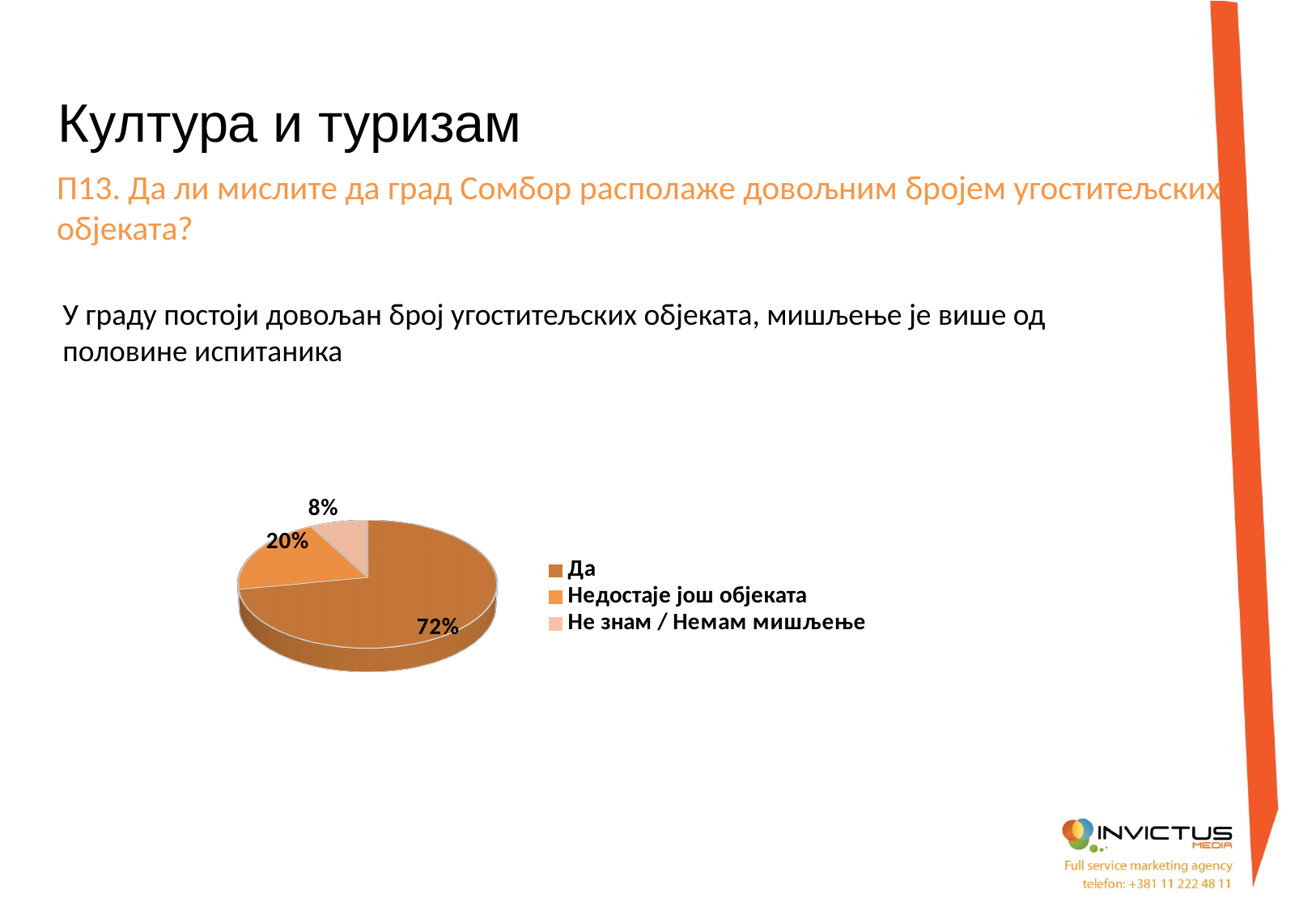
Which response has the largest share of the pie? Да Which response has the smallest share of the pie? Не знам / Немам мишљење Which legend entry is shown in the lightest colour? Не знам / Немам мишљење Which is larger: the share for "Недостаје још објеката" or for "Не знам / Немам мишљење"? Недостаје још објеката How many slices does the pie chart have? 3 What percentage of respondents answered "Недостаје још објеката"? 20% How many entries does the legend list? 3 What percentage of respondents answered "Не знам / Немам мишљење"? 8% What is the difference in percentage points between "Да" and "Недостаје још објеката"? 52 What percentage of respondents answered "Да"? 72% What is the difference in percentage points between "Недостаје још објеката" and "Не знам / Немам мишљење"? 12 What kind of chart is shown on the slide? Pie chart